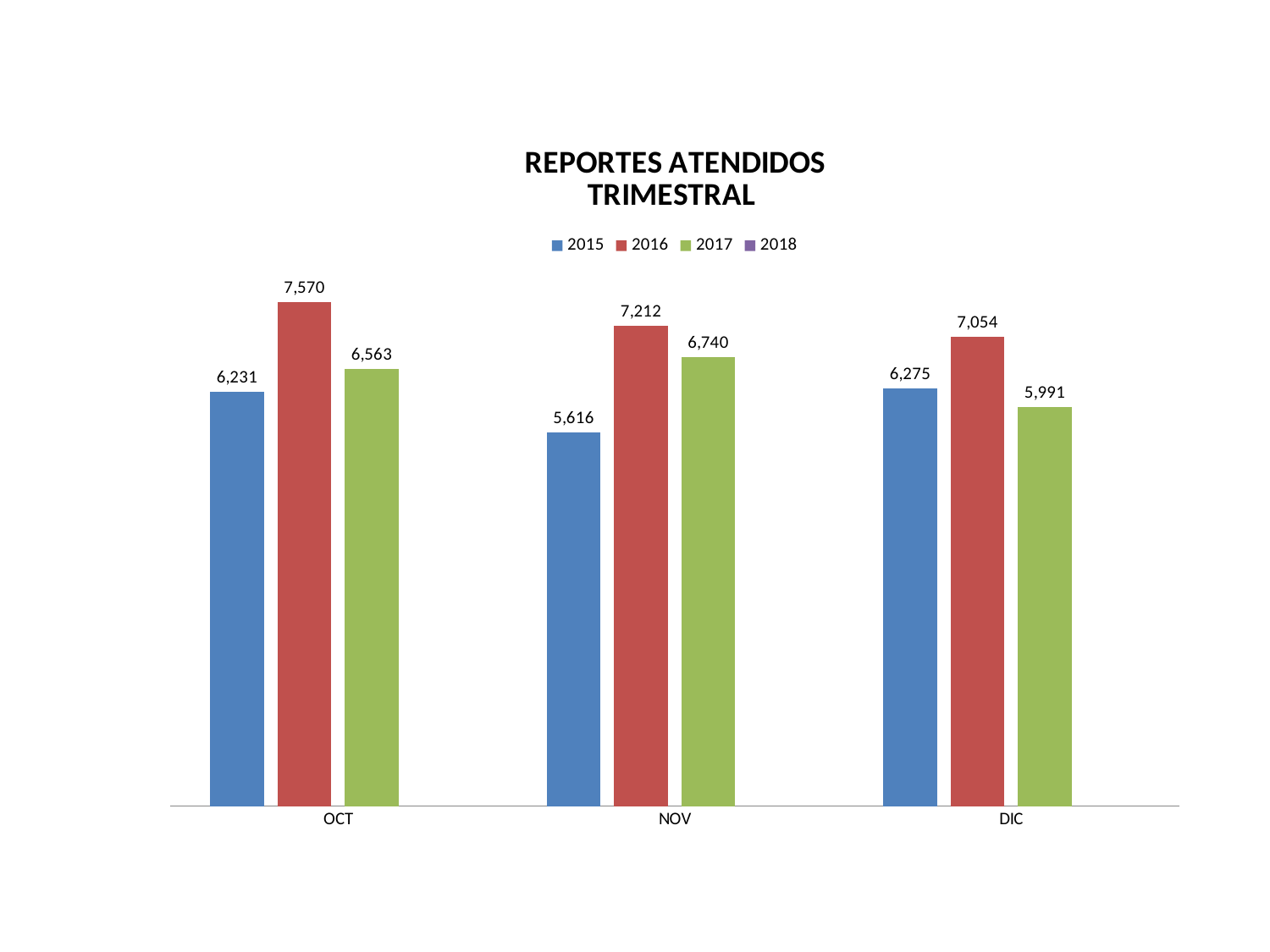
What is the value for 2016 in OCT? 7,570 How many months are shown on the x axis? 3 Which is larger in DIC: the 2015 value or the 2017 value? 2015 What is the value for 2017 in DIC? 5,991 What is the value for 2015 in NOV? 5,616 What is the title of the chart? REPORTES ATENDIDOS TRIMESTRAL What is the difference between the 2016 and 2015 values in OCT? 1,339 Which month has the lowest value for the 2015 series? NOV Does the 2017 series rise or fall from OCT to DIC? Fall Which month has the highest value for the 2016 series? OCT What kind of chart is shown? Bar chart How many series does the legend list? 4